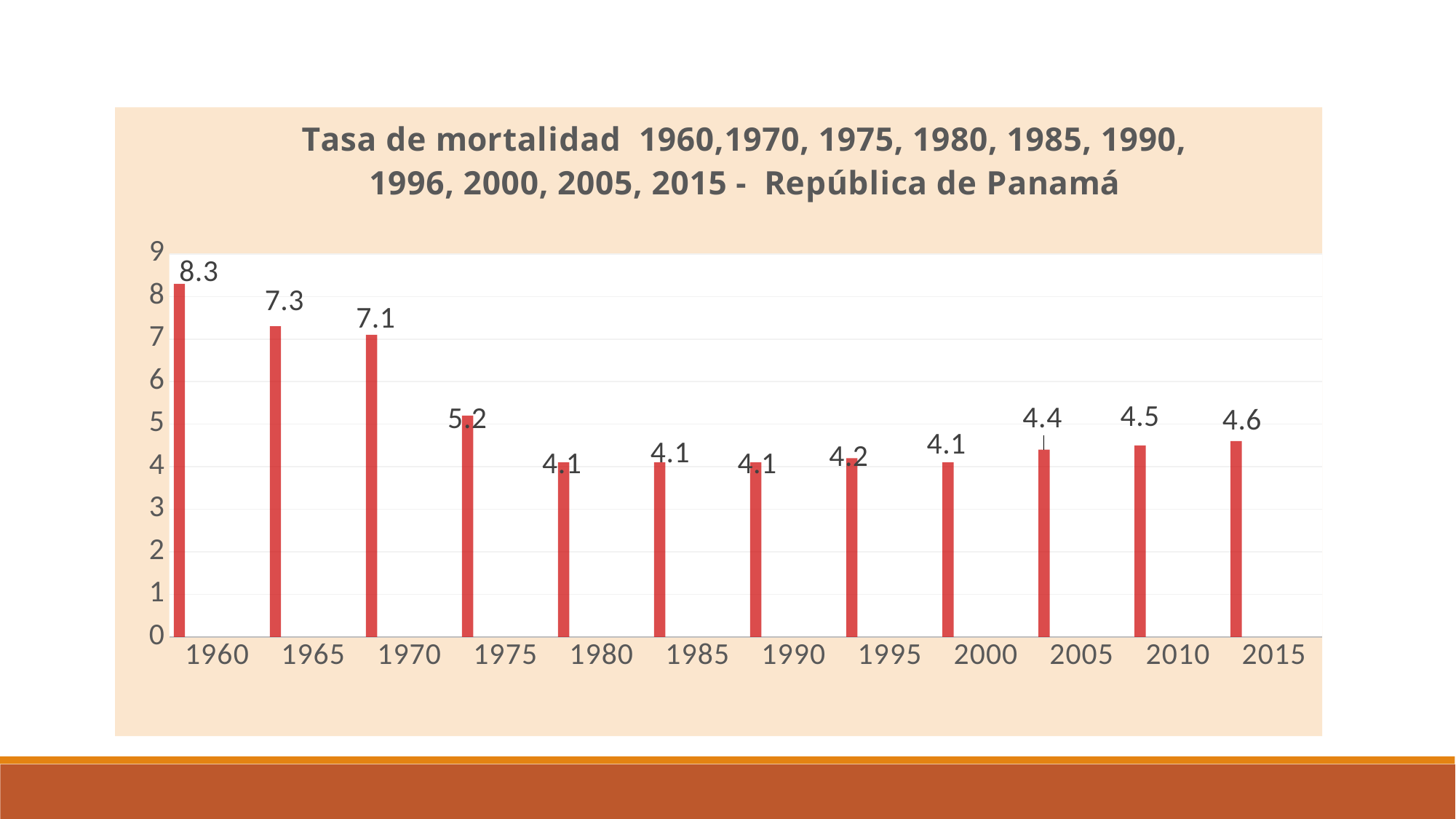
Which year has the highest mortality rate? 1960 What is the difference between the values for 1970 and 1975? 1.9 Is the value for 1970 greater or less than 6? greater Do the values generally rise or fall from 1960 to 1980? Fall What is the difference between the values for 1960 and 1965? 1.0 What is the value shown for 2015? 4.6 Which is larger, the value for 1965 or the value for 2010? 1965 How many bars are plotted in the chart? 12 What type of chart is shown on the slide? Bar chart What is the value shown for 1975? 5.2 What is the value shown for 2005? 4.4 What is the mortality rate value shown for 1960? 8.3